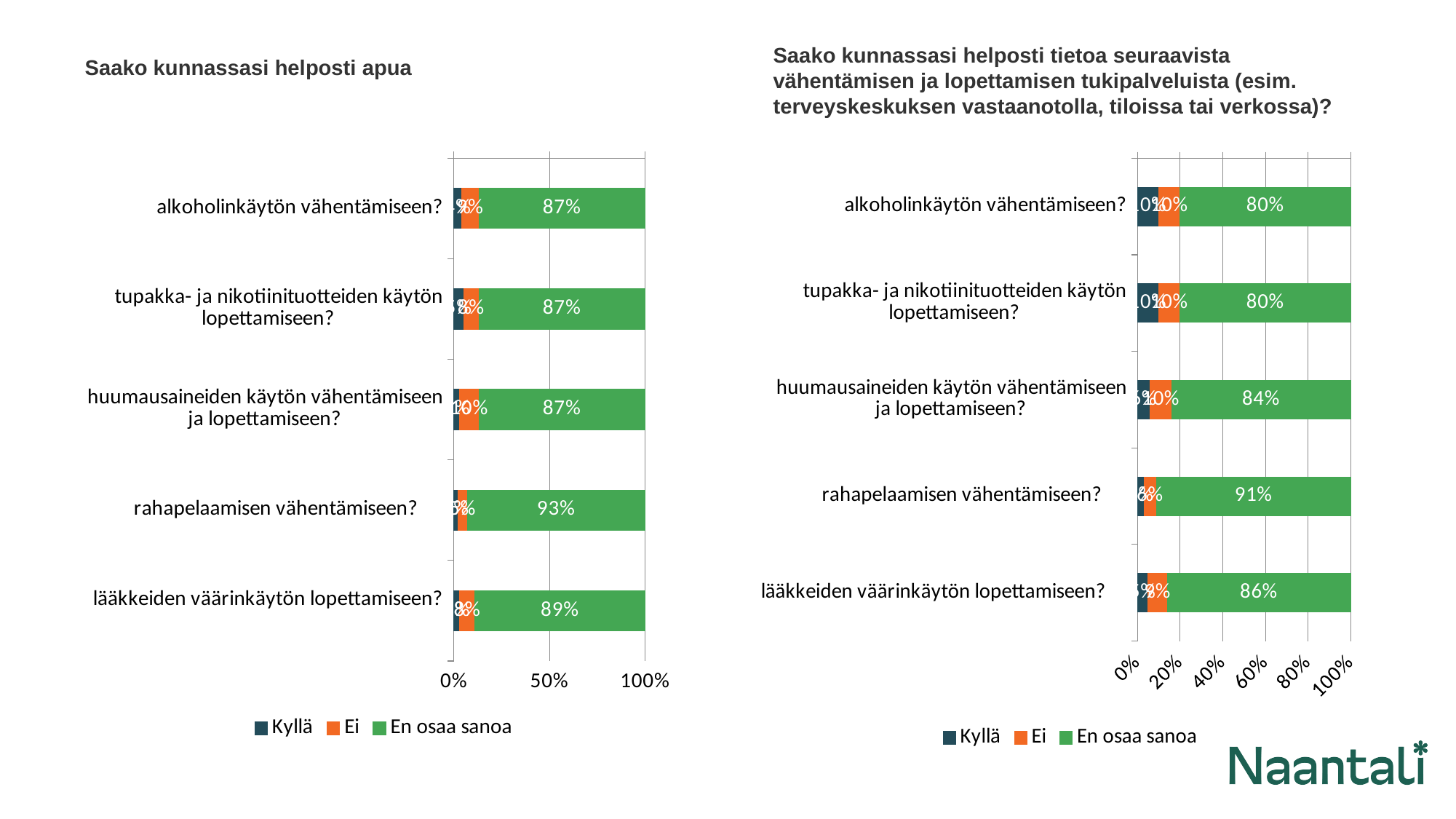
In the left chart titled "Saako kunnassasi helposti apua", what is the "En osaa sanoa" value for "rahapelaamisen vähentämiseen?"? 93% In the left chart titled "Saako kunnassasi helposti apua", what is the difference between the "En osaa sanoa" values for "rahapelaamisen vähentämiseen?" and "alkoholinkäytön vähentämiseen?"? 6% What kind of chart is the left chart titled "Saako kunnassasi helposti apua"? stacked bar chart In the right chart about "tietoa ... tukipalveluista", is the "En osaa sanoa" value for "lääkkeiden väärinkäytön lopettamiseen?" larger or smaller than that for "rahapelaamisen vähentämiseen?"? smaller How many series does the legend of the right chart list? 3 In the left chart titled "Saako kunnassasi helposti apua", how many categories are shown? 5 In the right chart about "tietoa ... tukipalveluista", what is the "Kyllä" value for "alkoholinkäytön vähentämiseen?"? 10% In the right chart about "tietoa ... tukipalveluista", what is the "En osaa sanoa" value for "rahapelaamisen vähentämiseen?"? 91% In the right chart about "tietoa ... tukipalveluista", what is the "En osaa sanoa" value for "huumausaineiden käytön vähentämiseen ja lopettamiseen?"? 84% In the left chart titled "Saako kunnassasi helposti apua", what is the "En osaa sanoa" value for "lääkkeiden väärinkäytön lopettamiseen?"? 89% In the right chart about "tietoa ... tukipalveluista", which category has the lowest "En osaa sanoa" value? alkoholinkäytön vähentämiseen? and tupakka- ja nikotiinituotteiden käytön lopettamiseen? (both 80%) In the left chart titled "Saako kunnassasi helposti apua", which category has the highest "En osaa sanoa" value? rahapelaamisen vähentämiseen?